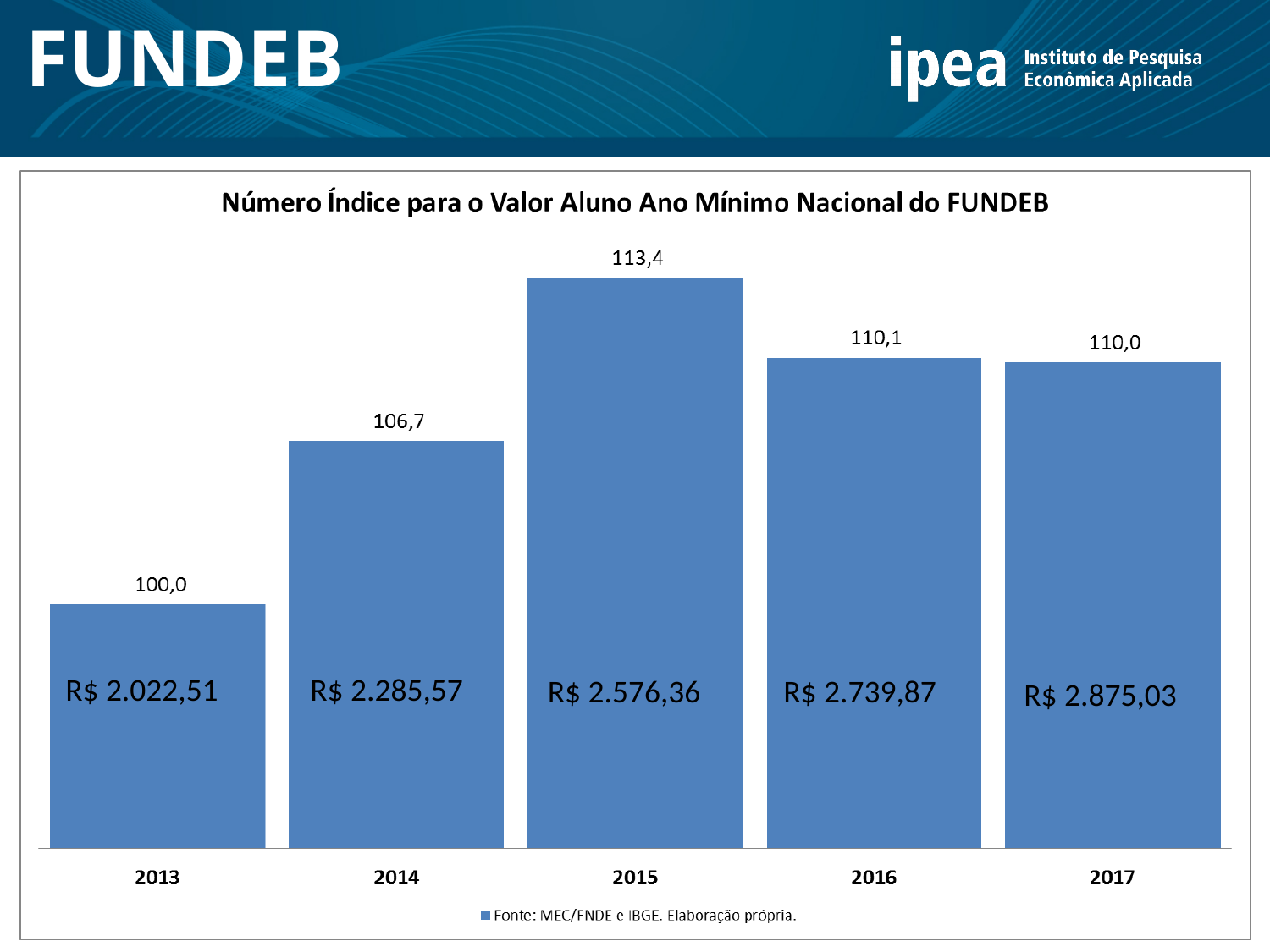
Which year has a larger index value, 2014 or 2016? 2016 What is the title of the chart? Número Índice para o Valor Aluno Ano Mínimo Nacional do FUNDEB What is the difference between the index values for 2016 and 2017? 0,1 Which year has the highest index value? 2015 What kind of chart is shown on the slide? Bar chart What is the difference between the index values for 2015 and 2014? 6,7 What is the index value shown for 2014? 106,7 What is the index value shown for 2015? 113,4 What R$ value is printed inside the bar for 2017? R$ 2.875,03 What R$ value is printed inside the bar for 2013? R$ 2.022,51 How many years are shown on the x axis? 5 Which year has the lowest index value? 2013